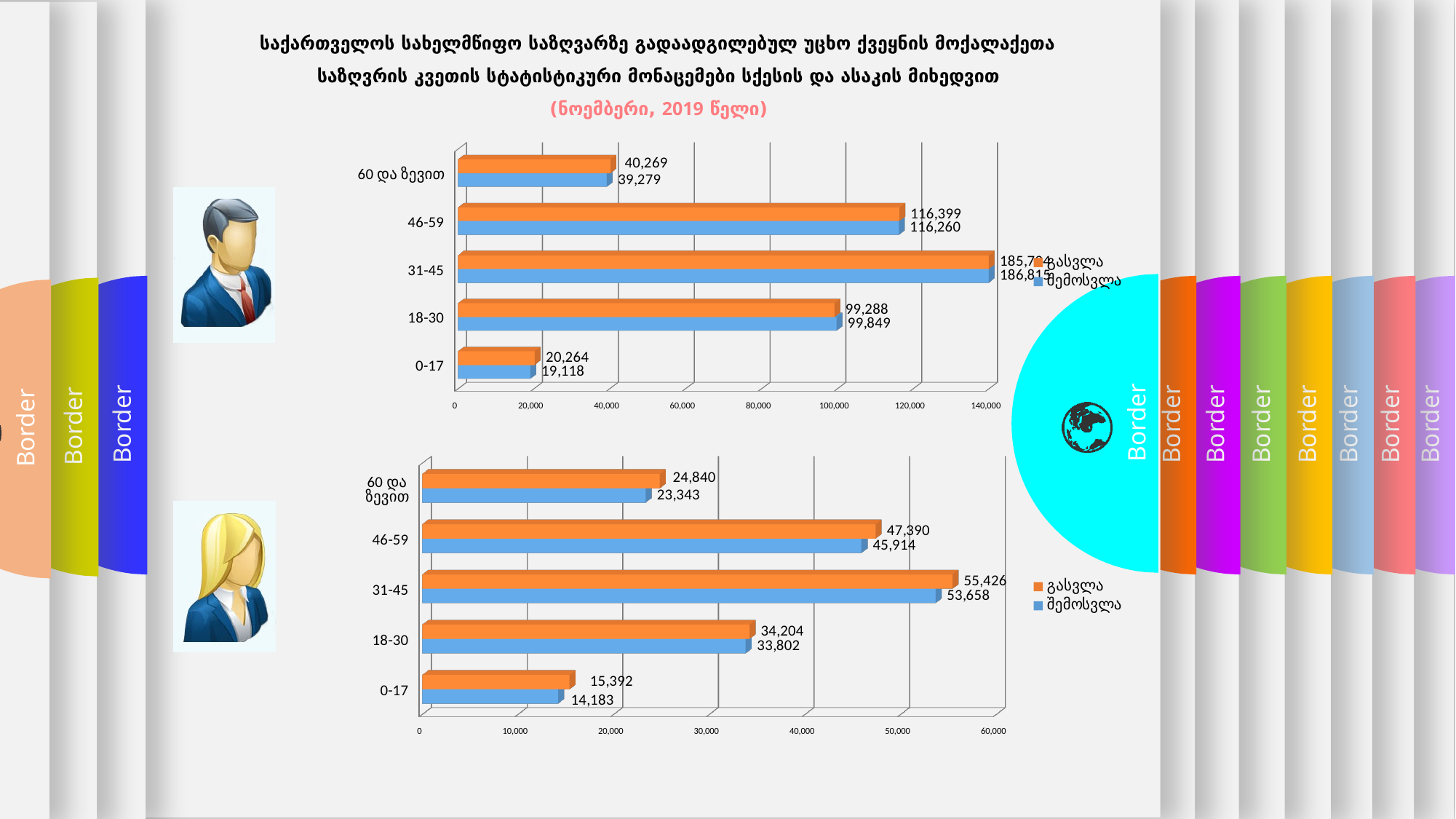
In the top chart, what is the difference between the გასვლა and შემოსვლა values for the 0-17 age group? 1,146 How many age groups are shown in the bottom chart? 5 In the bottom chart, what is the გასვლა value for the 31-45 age group? 55,426 In the bottom chart, which is larger for the 18-30 age group: გასვლა or შემოსვლა? გასვლა In the top chart, is the შემოსვლა value for the 18-30 age group greater or less than 100,000? less What type of chart is the top chart? Bar chart In the top chart, what is the შემოსვლა value for the 31-45 age group? 186,815 In the top chart, what is the გასვლა value for the 46-59 age group? 116,399 In the top chart, which age group has the lowest გასვლა value? 0-17 In the bottom chart, which age group has the highest შემოსვლა value? 31-45 In the bottom chart, what is the შემოსვლა value for the 0-17 age group? 14,183 In the bottom chart, what is the difference between the გასვლა and შემოსვლა values for the 46-59 age group? 1,476